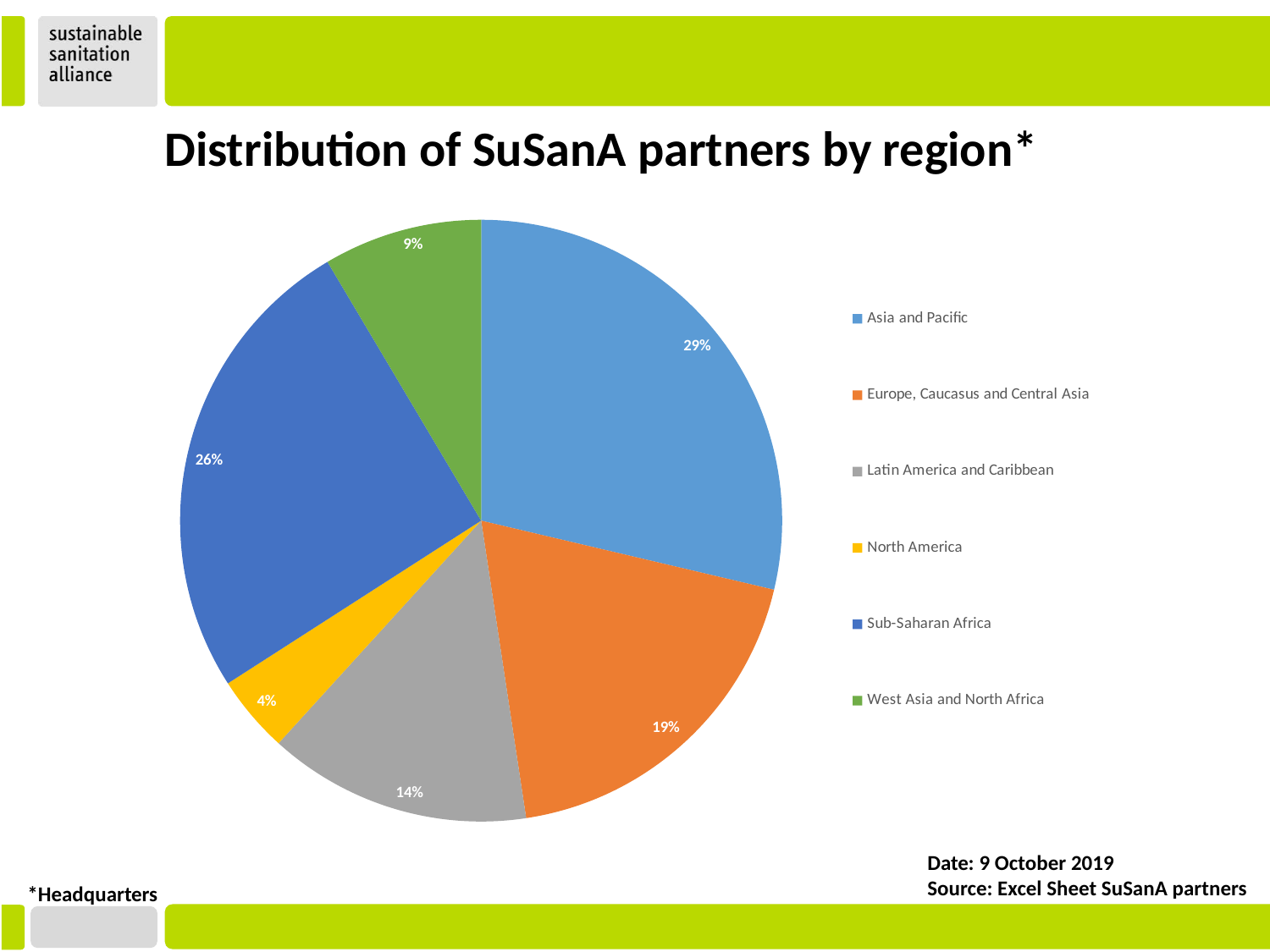
Which region has the largest share of SuSanA partners? Asia and Pacific Which has a larger share: Latin America and Caribbean or West Asia and North Africa? Latin America and Caribbean What share of SuSanA partners is in Asia and Pacific? 29% What is the difference in percentage points between the Asia and Pacific share and the Sub-Saharan Africa share? 3 Which colour represents North America in the pie chart? Yellow What share of SuSanA partners is in North America? 4% What kind of chart is shown on the slide? Pie chart What share of SuSanA partners is in Europe, Caucasus and Central Asia? 19% What is the title of the chart? Distribution of SuSanA partners by region* How many regions are shown in the pie chart? 6 Which region has the smallest share of SuSanA partners? North America What share of SuSanA partners is in Sub-Saharan Africa? 26%